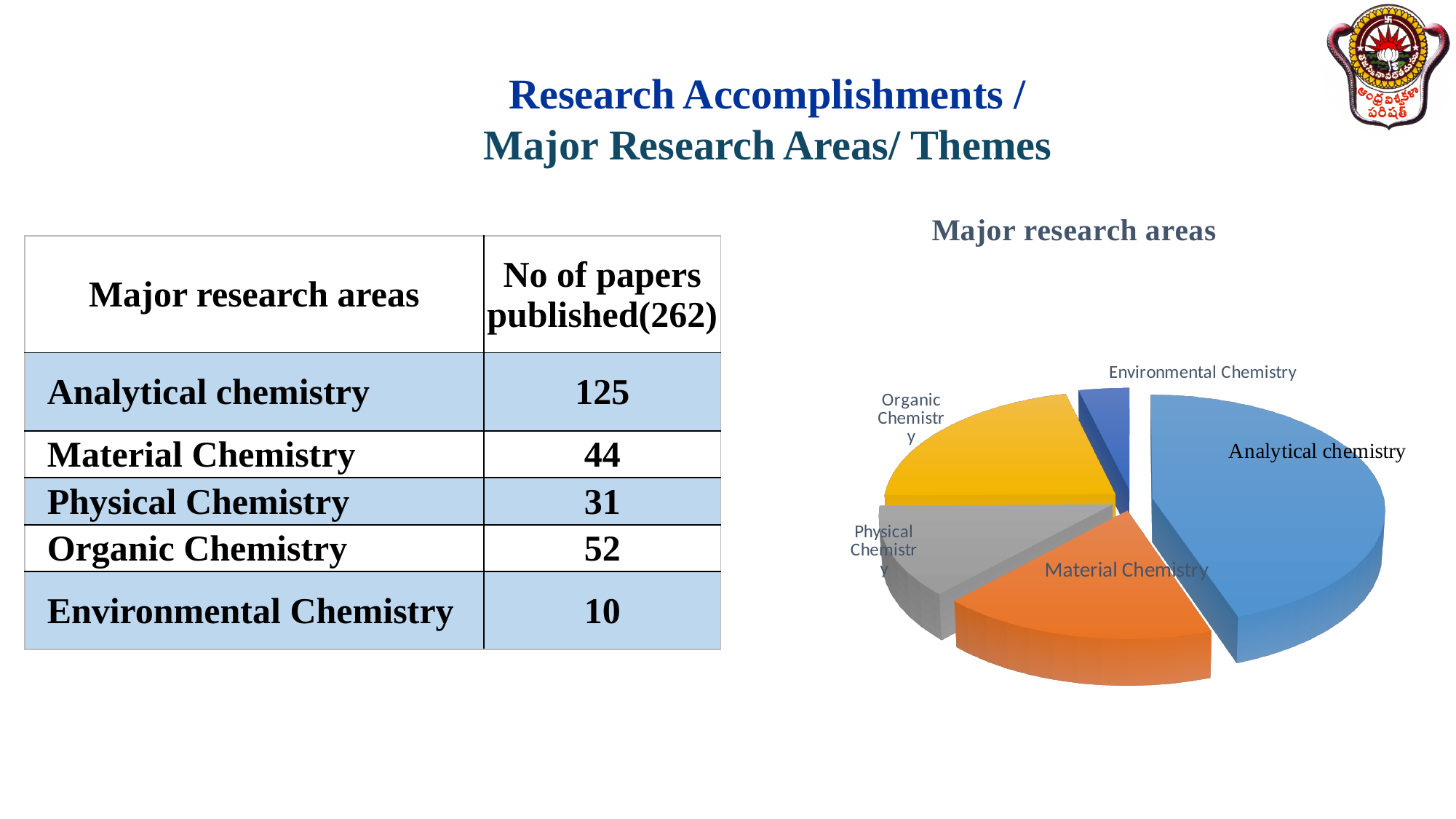
How many papers were published in Organic Chemistry? 52 Which research area has the smallest slice in the pie chart? Environmental Chemistry How many slices does the pie chart have? 5 Which research area has the largest slice in the pie chart? Analytical chemistry What is the title of the pie chart? Major research areas Which colour represents Material Chemistry in the pie chart? orange Which has more papers published, Material Chemistry or Physical Chemistry? Material Chemistry What is the total number of papers published across all research areas? 262 What type of chart is shown on the slide? pie chart How many papers were published in Environmental Chemistry? 10 How many papers were published in Analytical chemistry? 125 What is the difference in papers published between Analytical chemistry and Organic Chemistry? 73